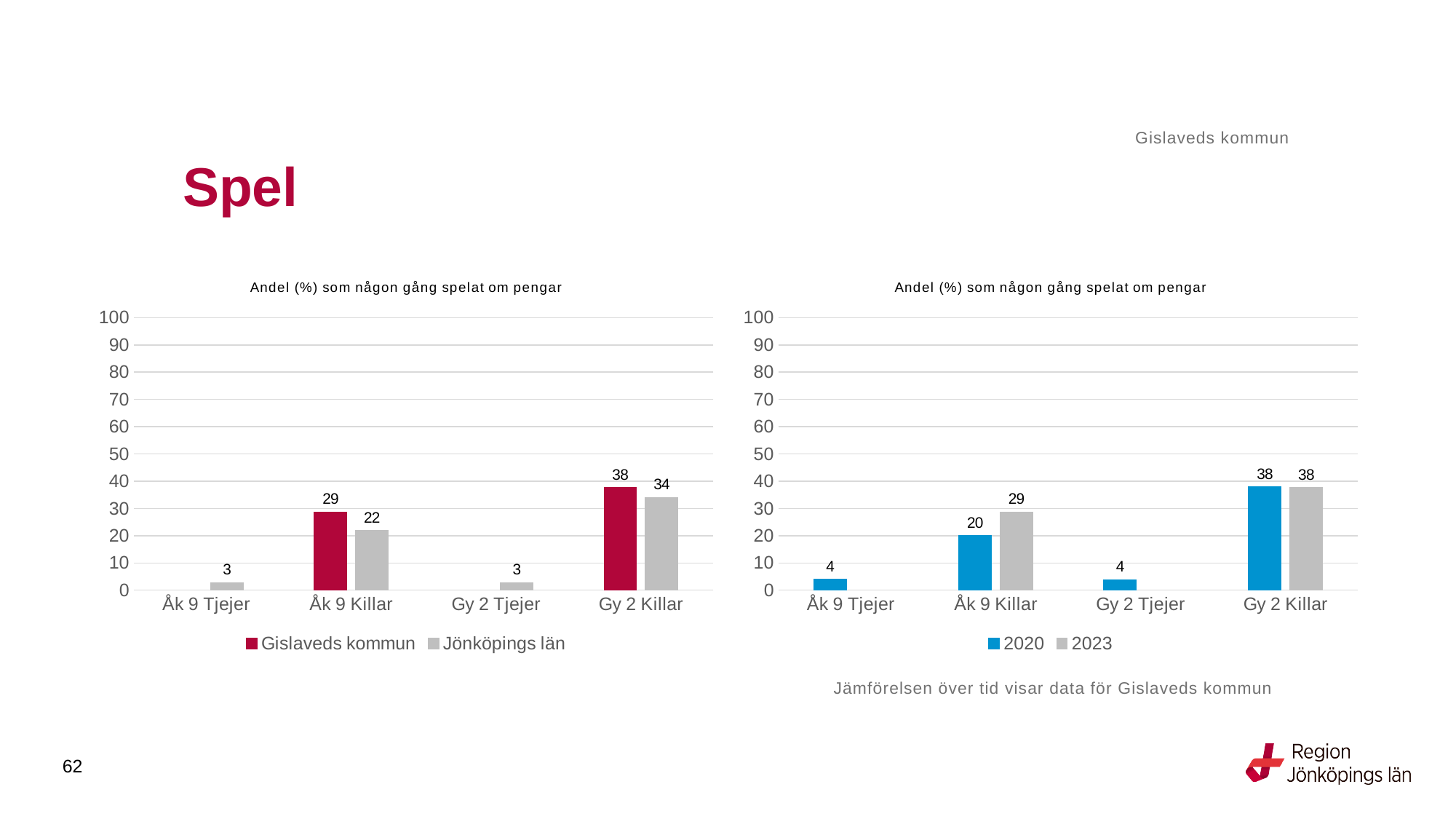
What kind of chart is the right chart? Bar chart How many categories are shown on the x axis of the left chart? 4 In the right chart, which category has the lowest 2020 value? Åk 9 Tjejer and Gy 2 Tjejer (both 4) In the left chart, what is the value for Jönköpings län for Gy 2 Killar? 34 In the left chart, how many series does the legend list? 2 In the right chart, what is the difference between the 2023 and 2020 values for Åk 9 Killar? 9 In the right chart, which is larger for Gy 2 Killar, the 2020 value or the 2023 value? They are equal (38) In the left chart, what is the difference between Gislaveds kommun and Jönköpings län for Gy 2 Killar? 4 In the left chart, which category has the highest value for Jönköpings län? Gy 2 Killar In the right chart, what is the 2020 value for Åk 9 Killar? 20 In the left chart, what is the value for Gislaveds kommun for Åk 9 Killar? 29 In the right chart, what is the 2023 value for Åk 9 Killar? 29